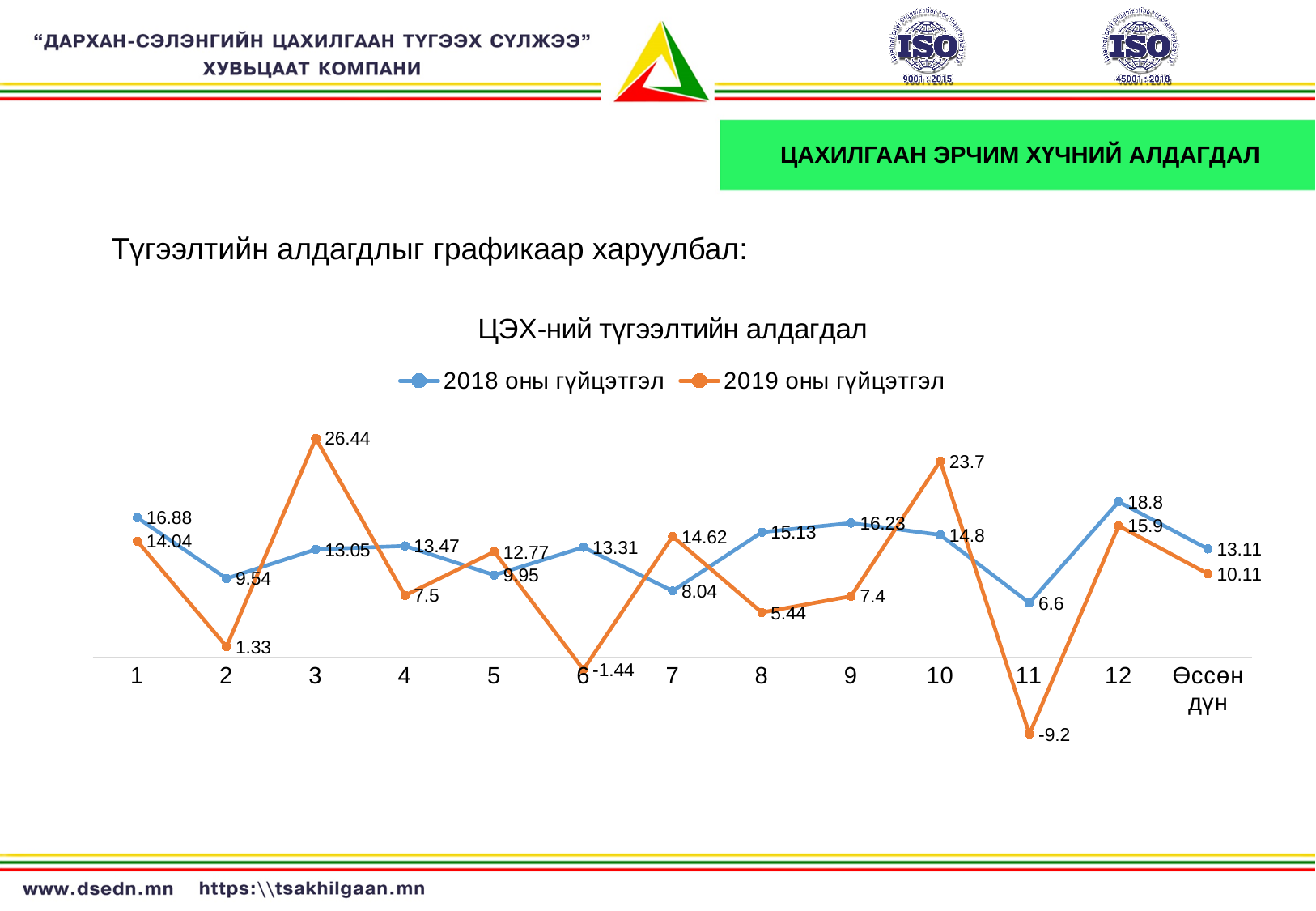
Which category has the lowest value for 2019 оны гүйцэтгэл? 11 At category 10, which series has the larger value, 2018 оны гүйцэтгэл or 2019 оны гүйцэтгэл? 2019 оны гүйцэтгэл What is the value for 2019 оны гүйцэтгэл at Өссөн дүн? 10.11 What is the title of the chart? ЦЭХ-ний түгээлтийн алдагдал What is the value for 2019 оны гүйцэтгэл at category 3? 26.44 What type of chart is shown on the slide? line chart Which category has the highest value for 2018 оны гүйцэтгэл? 12 What is the value for 2019 оны гүйцэтгэл at category 6? -1.44 What is the value for 2018 оны гүйцэтгэл at category 11? 6.6 What is the difference between 2018 оны гүйцэтгэл and 2019 оны гүйцэтгэл at category 2? 8.21 How many categories are shown on the x axis? 13 How many series does the legend list? 2